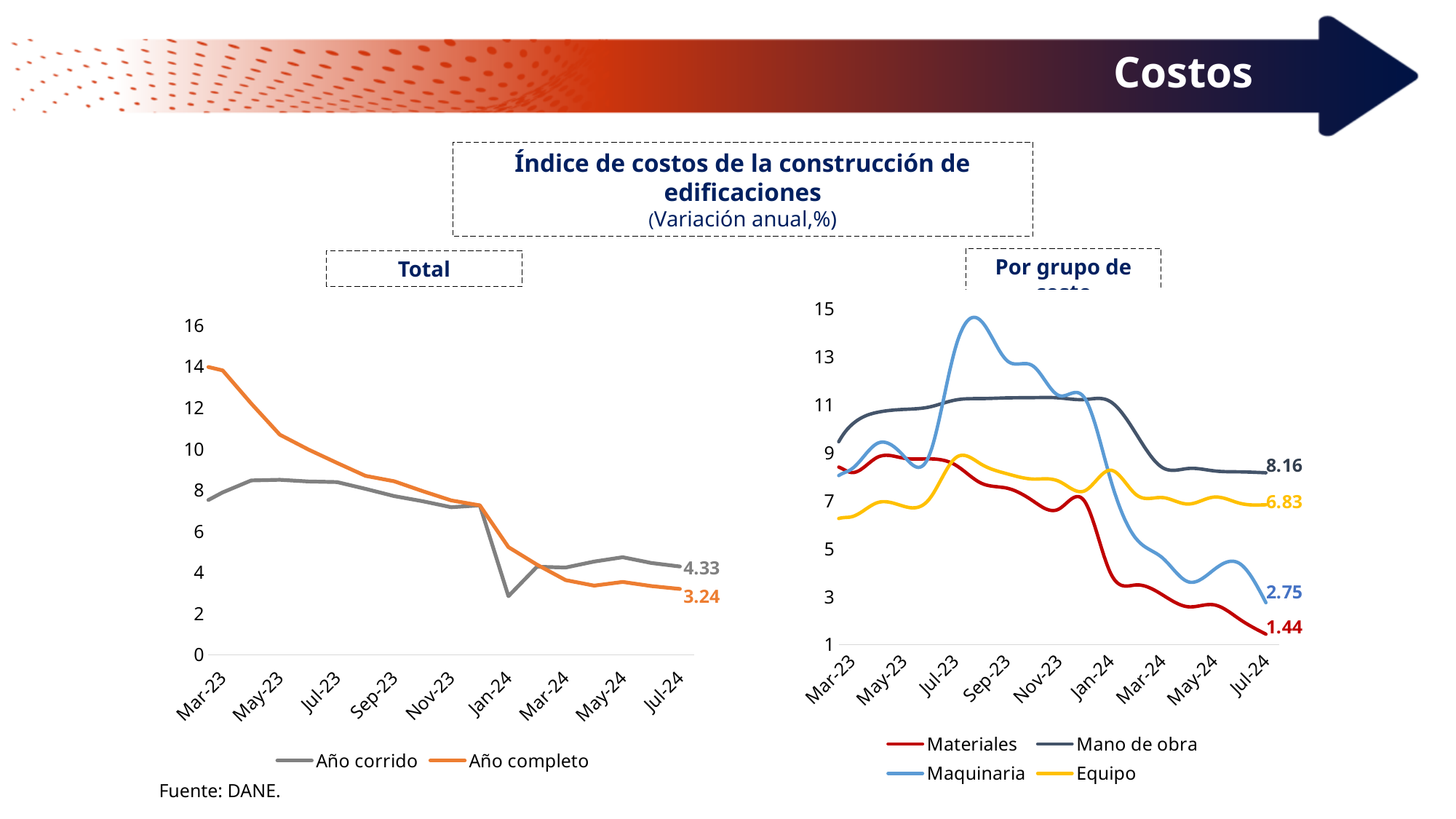
In the 'Total' chart, what is the difference between the Jul-24 values of Año corrido and Año completo? 1.09 In the 'Total' chart, what is the final value shown for Año completo in Jul-24? 3.24 In the 'Total' chart, which series has the higher value in Jul-24, Año corrido or Año completo? Año corrido In the 'Total' chart, is the Mar-23 value for Año completo greater or less than 12? greater In the 'Por grupo de costo' chart, which series has the highest value in Jul-24? Mano de obra In the 'Por grupo de costo' chart, what is the difference between the Jul-24 values of Equipo and Maquinaria? 4.08 What kind of chart is the 'Por grupo de costo' chart? Line chart In the 'Total' chart, what is the final value shown for Año corrido in Jul-24? 4.33 In the 'Por grupo de costo' chart, what is the Jul-24 value for Materiales? 1.44 In the 'Total' chart, how many series does the legend list? 2 In the 'Por grupo de costo' chart, what is the Jul-24 value for Mano de obra? 8.16 In the 'Por grupo de costo' chart, which series has the lowest value in Jul-24? Materiales